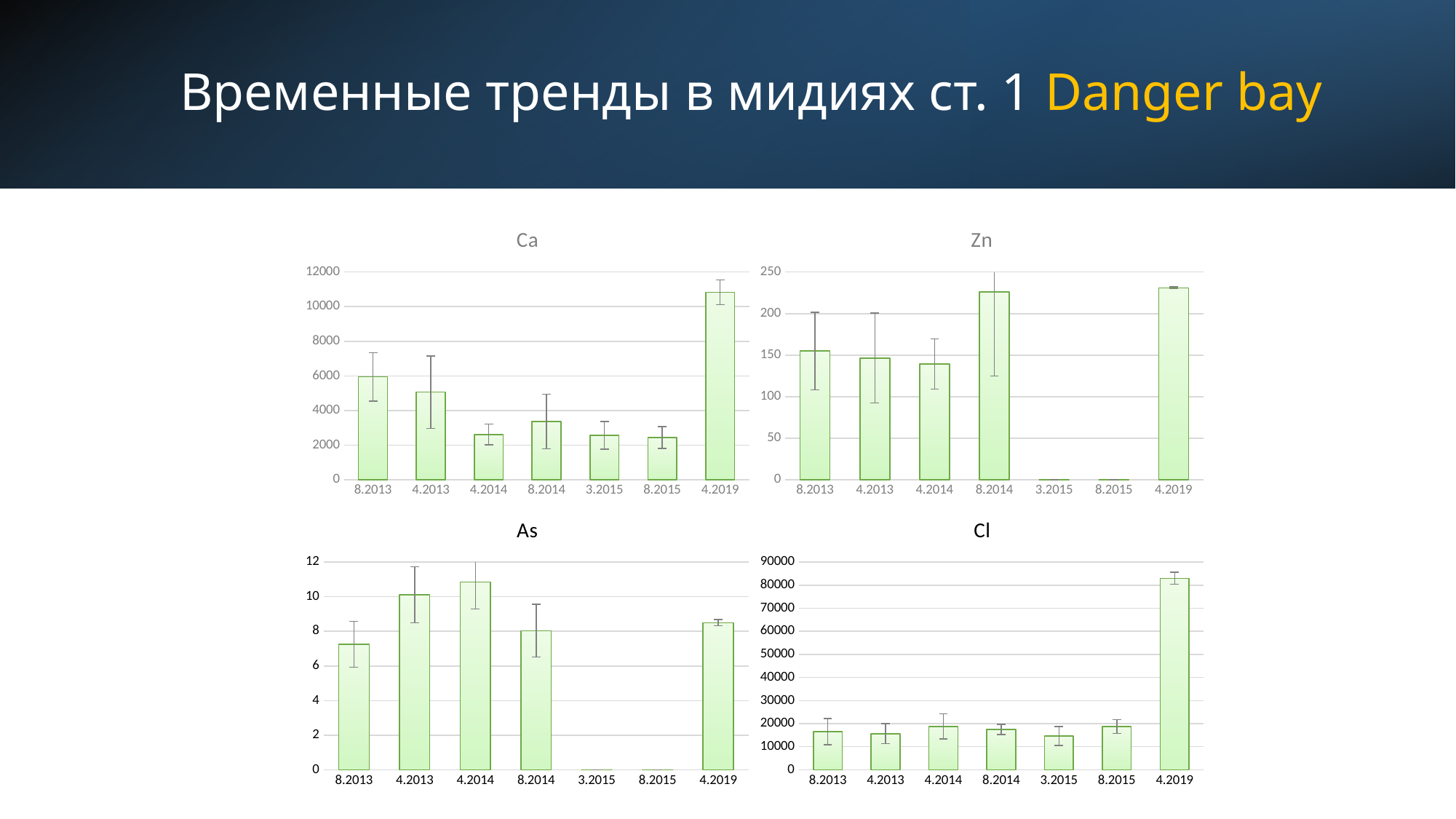
In the Zn chart, is the value for 8.2013 greater or less than 100? greater In the Ca chart, which category has the highest value? 4.2019 In the Ca chart, is the value for 4.2019 greater or less than 10000? greater In the Zn chart, is the value for 4.2019 greater or less than 200? greater What kind of chart is the Ca chart? bar chart How many categories are shown on the x axis of the Cl chart? 7 In the As chart, which is larger, the value for 4.2014 or the value for 8.2013? 4.2014 What is the title of the chart in the top right of the slide? Zn In the Cl chart, which category has the highest value? 4.2019